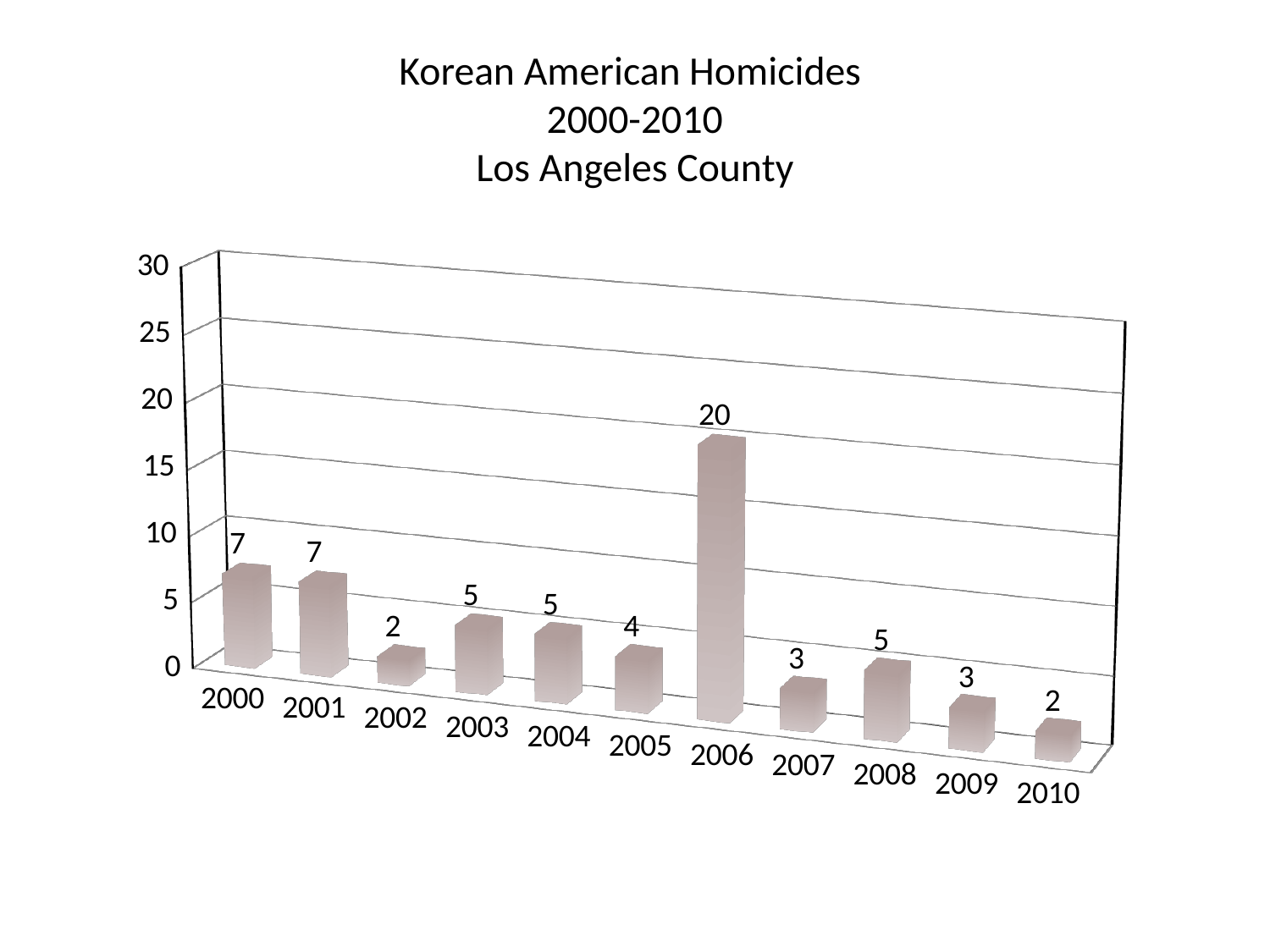
Do the values rise or fall from 2006 to 2007? fall How many years are shown on the x axis? 11 What kind of chart is this? bar chart Which year has the highest value? 2006 What is the value for 2006? 20 What is the difference between the values for 2000 and 2002? 5 What is the value for 2003? 5 Which is larger, the value for 2001 or the value for 2007? 2001 What is the title of the chart? Korean American Homicides 2000-2010 Los Angeles County What is the value for 2010? 2 Is the value for 2006 greater or less than 15? greater What is the difference between the values for 2006 and 2005? 16